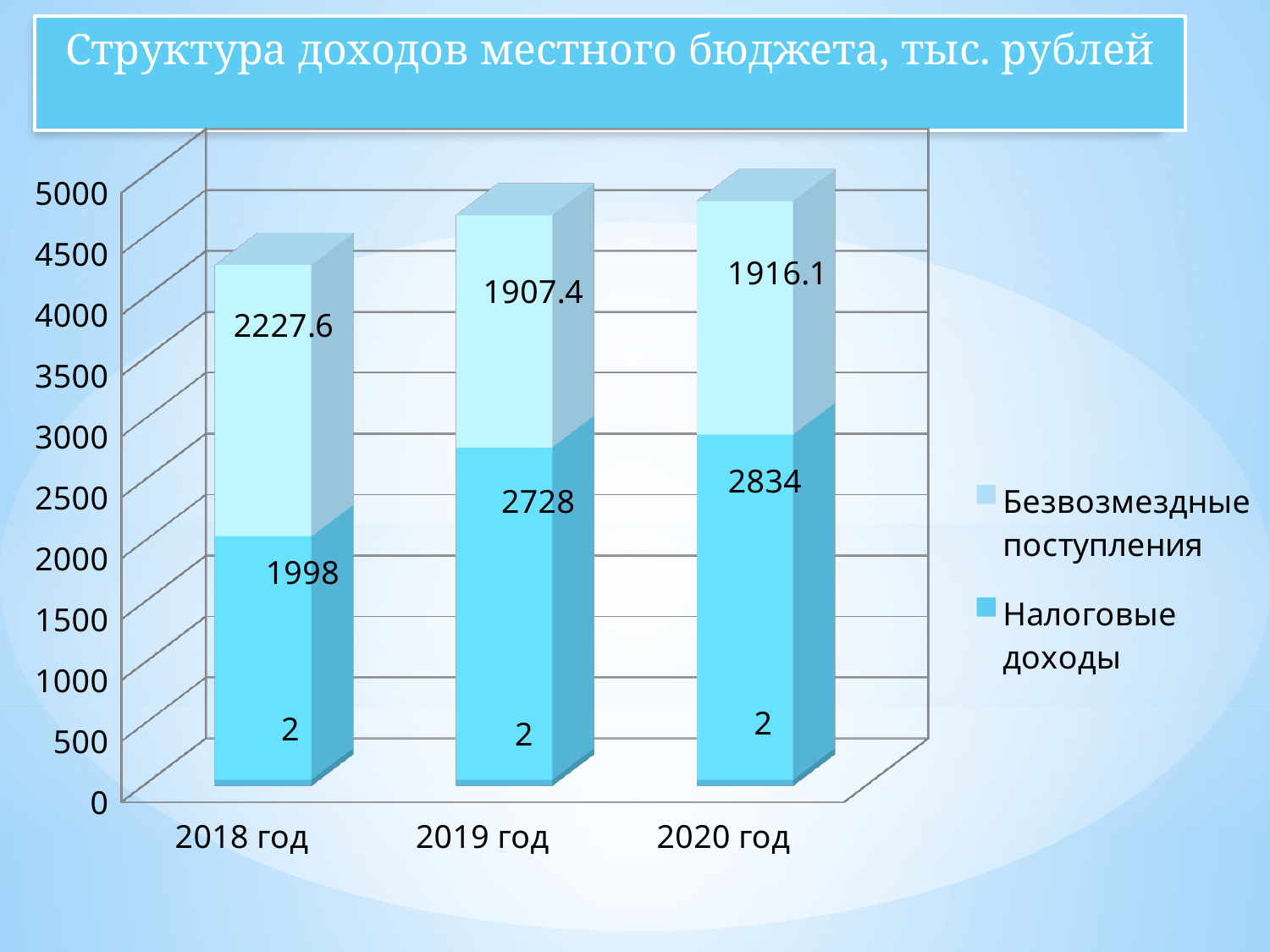
What kind of chart is shown on the slide? Stacked bar chart Which is larger: Безвозмездные поступления in 2018 год or in 2020 год? 2018 год What is the value of Налоговые доходы for 2018 год? 1998 Do the values of Налоговые доходы rise or fall from 2018 год to 2020 год? Rise What is the value of Безвозмездные поступления for 2018 год? 2227.6 What is the value of Безвозмездные поступления for 2019 год? 1907.4 What is the difference between Налоговые доходы in 2020 год and 2018 год? 836 Which year has the lowest value of Безвозмездные поступления? 2019 год How many series does the legend list? 2 What is the value of Налоговые доходы for 2020 год? 2834 How many years are shown on the x axis? 3 Which year has the highest value of Налоговые доходы? 2020 год